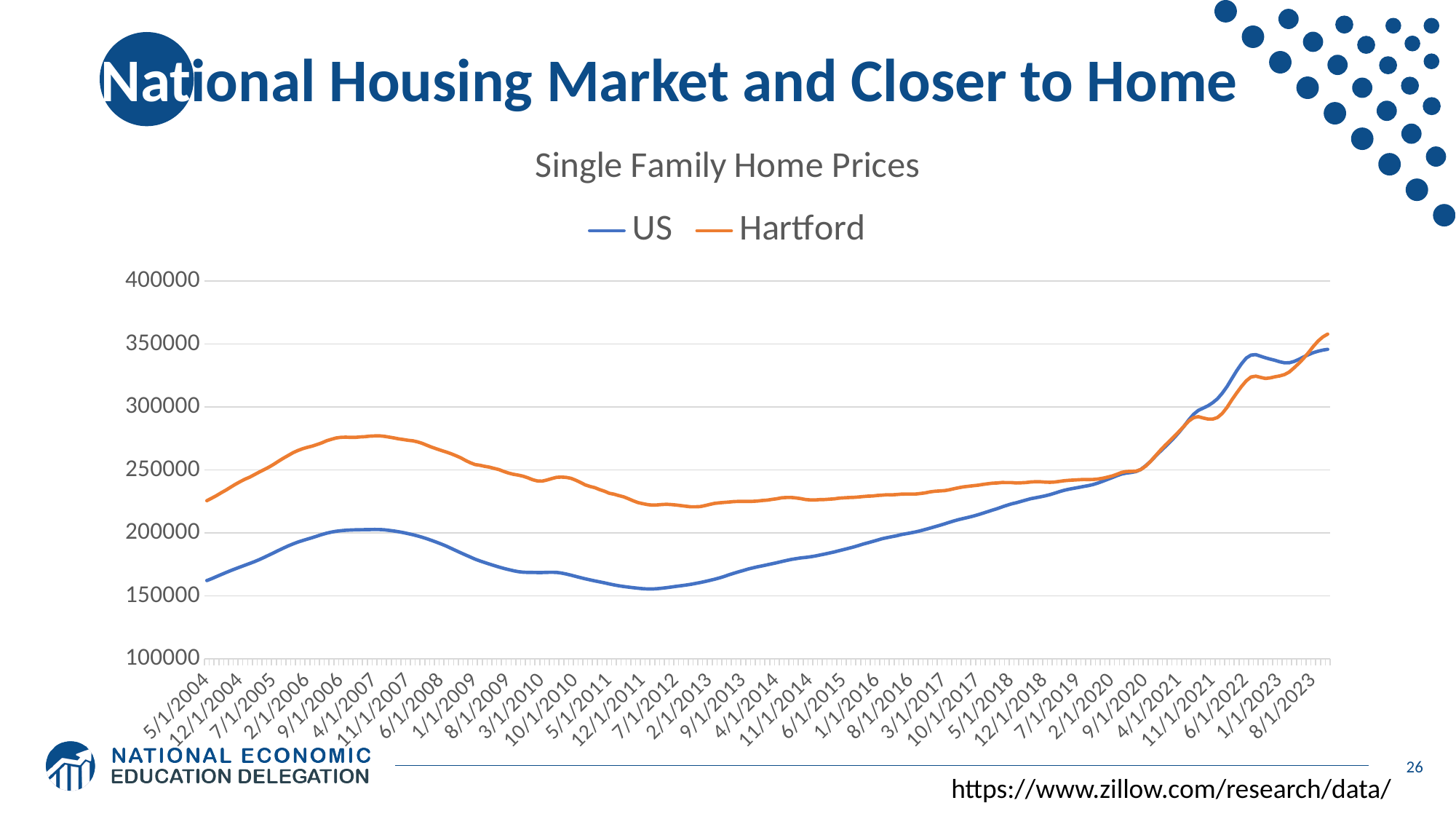
Is the value for US at 5/1/2004 greater or less than 200000? less How many series does the legend list? 2 Is the value for Hartford at 7/1/2012 greater or less than 250000? less Is the value for US at 8/1/2023 greater or less than 300000? greater Which series is drawn in orange? Hartford Does the US series rise or fall between 7/1/2011 and 8/1/2023? rise What kind of chart is shown on the slide? line chart Which series has the larger value at 6/1/2022, US or Hartford? US What is the title of the chart? Single Family Home Prices Which series has the larger value at 5/1/2004, US or Hartford? Hartford